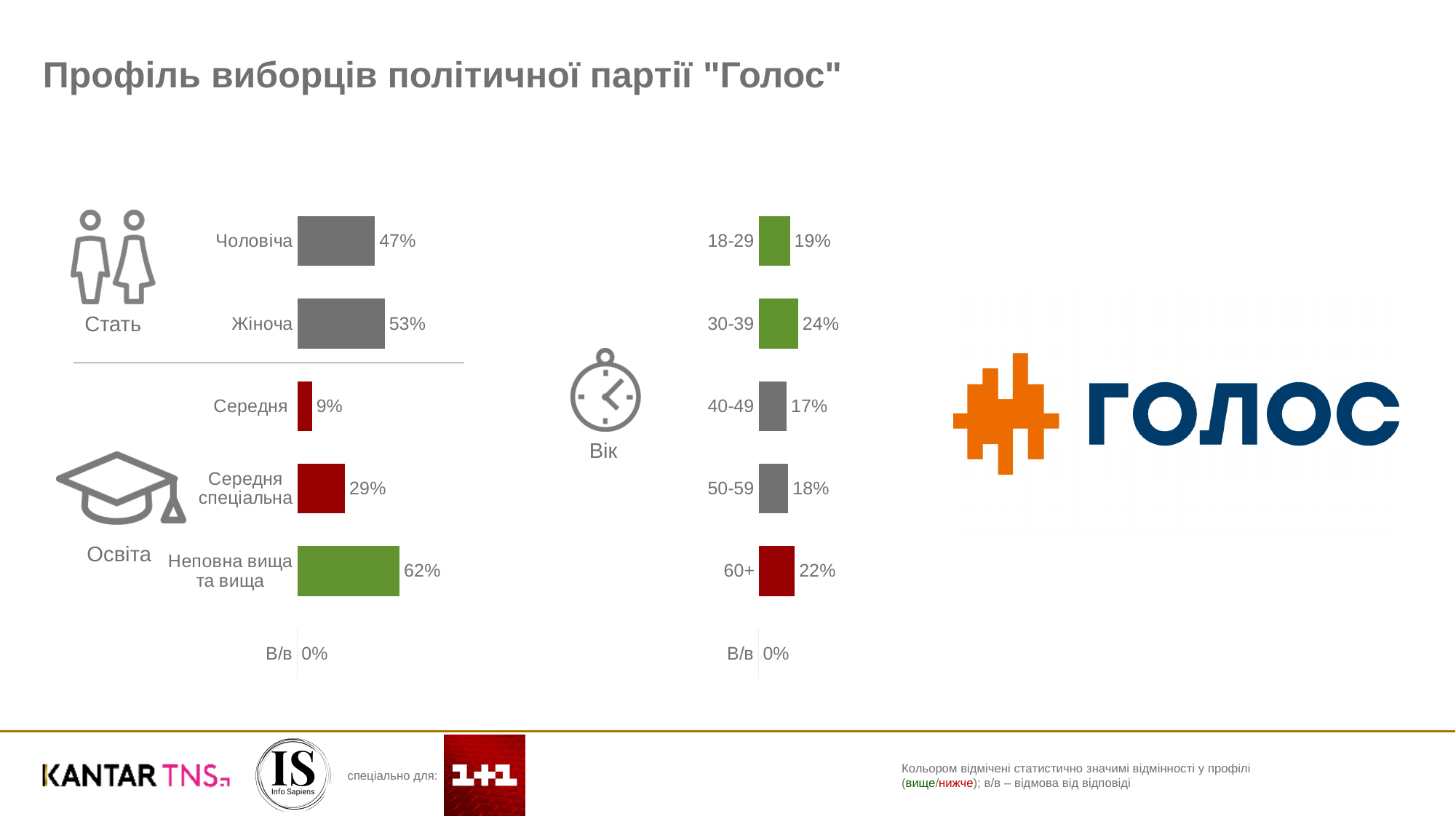
In the "Освіта" chart, which category has the highest value? Неповна вища та вища What type of chart is the "Вік" chart? Bar chart In the "Освіта" chart, what is the difference between "Неповна вища та вища" and "Середня"? 53% In the "Стать" chart, what is the value for "Чоловіча"? 47% In the "Стать" chart, what is the difference between "Жіноча" and "Чоловіча"? 6% In the "Вік" chart, what is the value for "30-39"? 24% In the "Вік" chart, which is larger: "60+" or "18-29"? 60+ In the "Вік" chart, how many age categories are shown, including "В/в"? 6 In the "Стать" chart, what is the value for "Жіноча"? 53% In the "Освіта" chart, what is the value for "Середня спеціальна"? 29% In the "Вік" chart, which age group has the lowest non-zero value? 40-49 In the "Вік" chart, what is the value for "В/в"? 0%